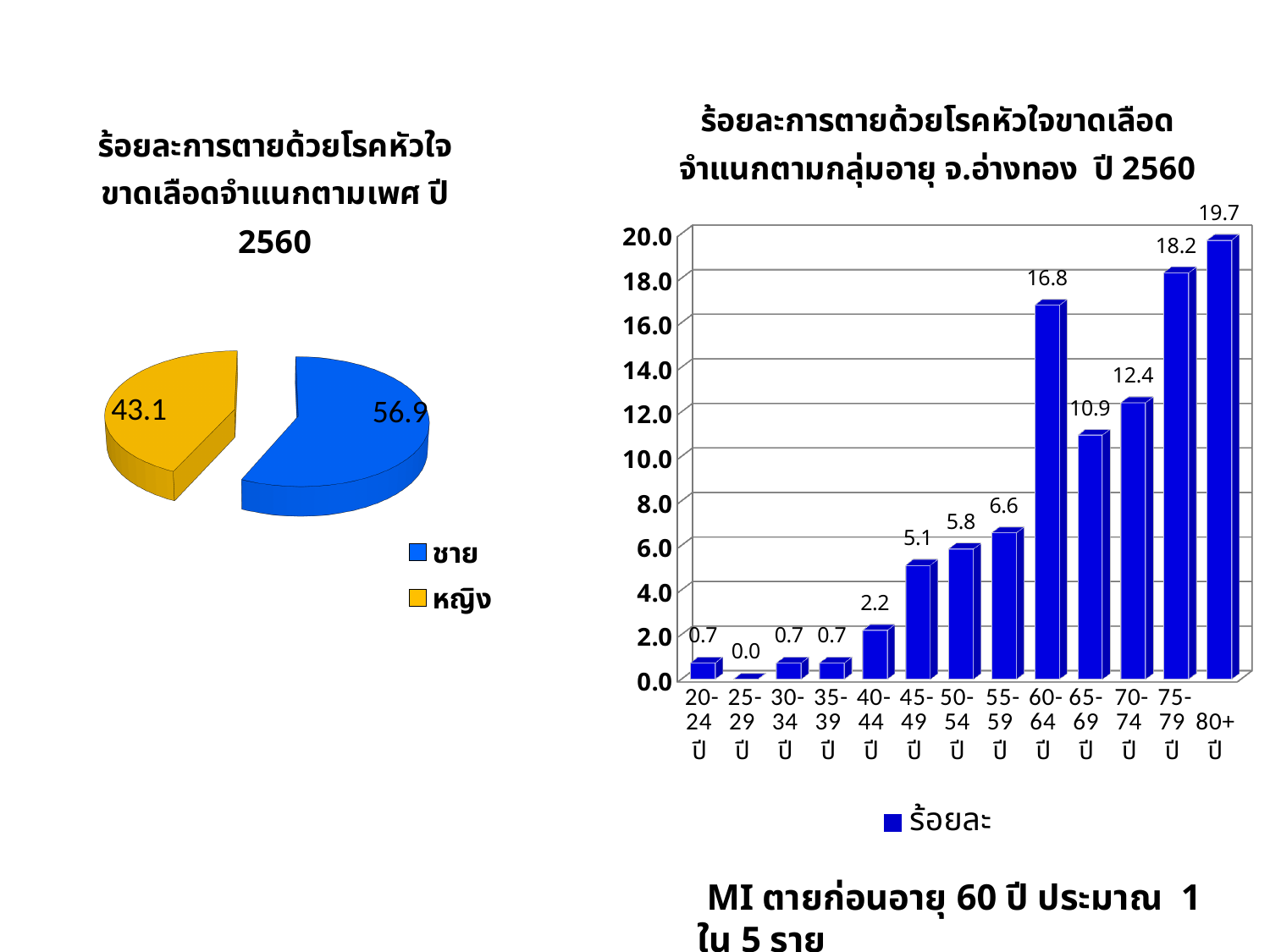
In the bar chart on the right, which is larger, the value for 65-69 ปี or 70-74 ปี? 70-74 ปี What type of chart is the chart on the right? bar chart In the bar chart on the right, which age group has the lowest value? 25-29 ปี In the bar chart on the right, what is the difference between the values for 80+ ปี and 75-79 ปี? 1.5 In the pie chart on the left, which category has the larger share, ชาย or หญิง? ชาย In the bar chart on the right, how many age groups are shown on the x axis? 13 In the bar chart on the right, what is the value for the 60-64 ปี age group? 16.8 In the pie chart on the left, how many slices are there? 2 In the pie chart on the left, what is the value for หญิง? 43.1 In the bar chart on the right, what is the value for the 45-49 ปี age group? 5.1 In the pie chart on the left, what is the value for ชาย? 56.9 In the bar chart on the right, which age group has the highest value? 80+ ปี